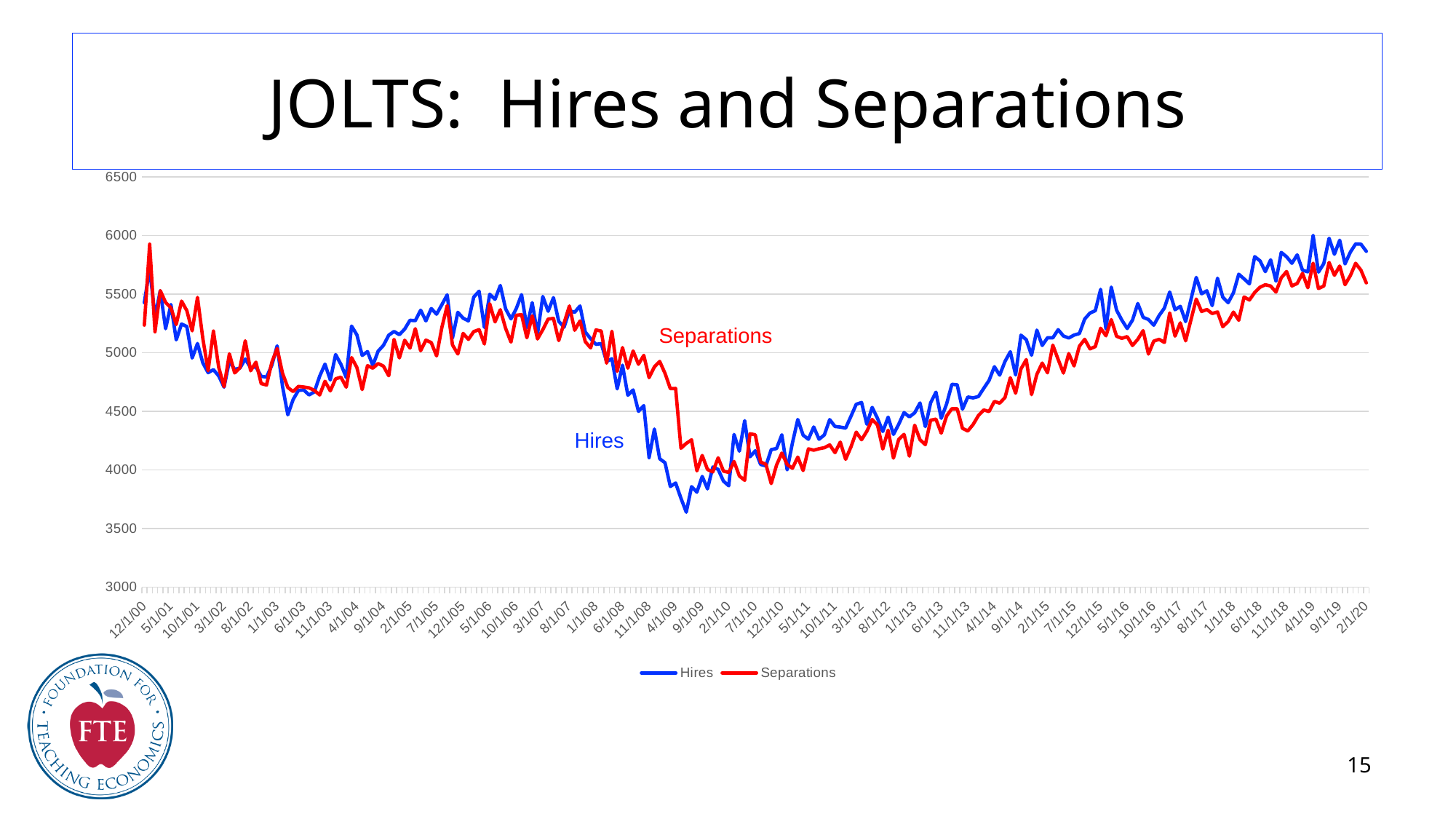
What colour is the Hires line? blue Around 6/1/18, which series is higher, Hires or Separations? Hires Is the value of Hires at 12/1/00 greater or less than 5000? greater Is the value of Hires at its lowest point in 2009 greater or less than 4000? less What is the title of the chart? JOLTS: Hires and Separations How many series does the legend list? 2 Is the value of Separations at 2/1/20 greater or less than 5000? greater Do Hires rise or fall between 6/1/08 and 4/1/09? fall Around 4/1/09, which series is higher, Hires or Separations? Separations In which year does the Hires series reach its lowest value? 2009 What kind of chart is shown on the slide? line chart